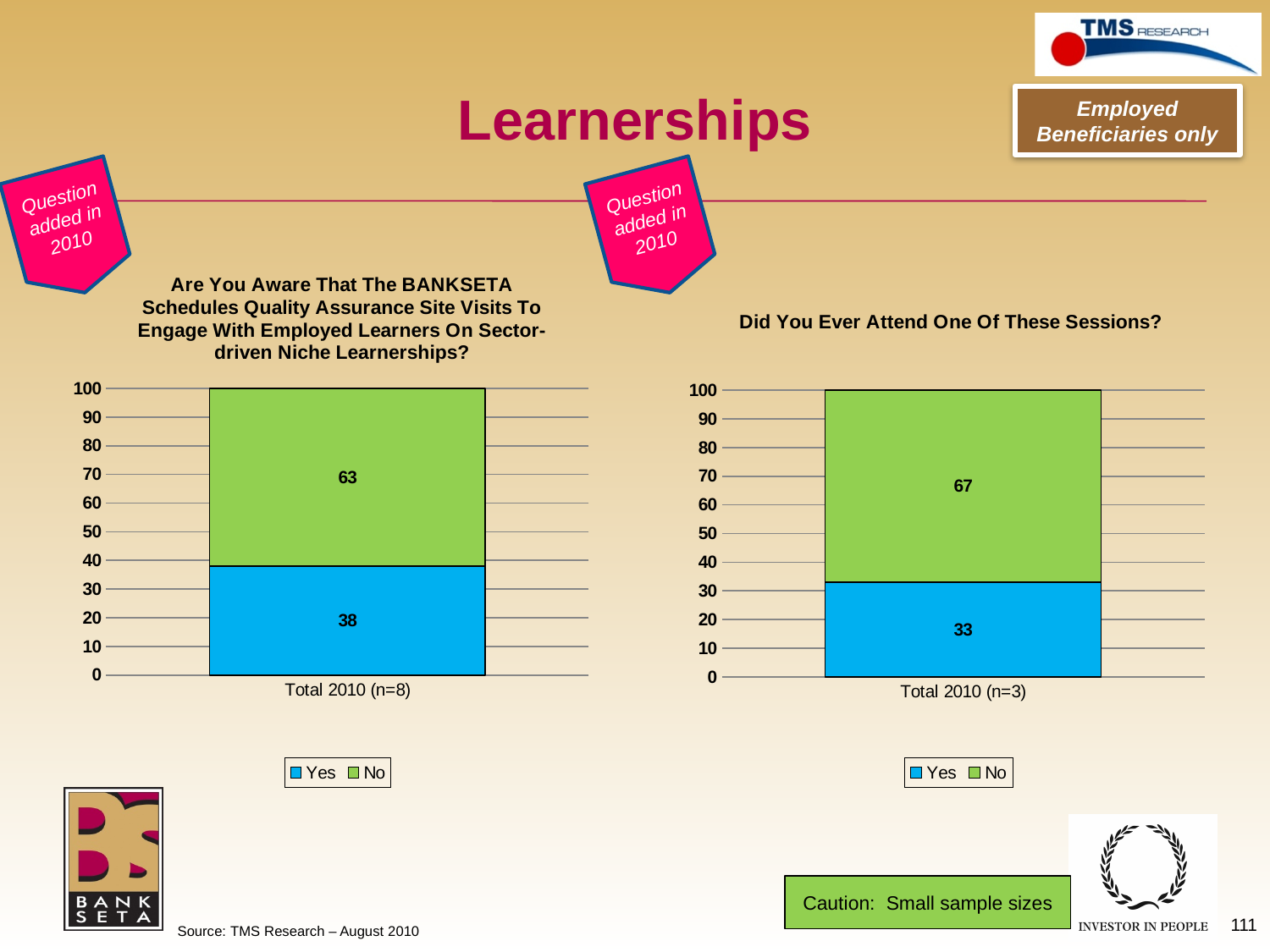
In the right chart (Did You Ever Attend One Of These Sessions?), what is the value for Yes? 33 In the right chart (Did You Ever Attend One Of These Sessions?), which series has the smaller value, Yes or No? Yes What kind of chart is the right chart (Did You Ever Attend One Of These Sessions?)? Stacked bar chart What is the category label on the x axis of the right chart (Did You Ever Attend One Of These Sessions?)? Total 2010 (n=3) In the left chart (Are You Aware That The BANKSETA Schedules Quality Assurance Site Visits...), what is the difference between the No and Yes values? 25 In the right chart (Did You Ever Attend One Of These Sessions?), what is the total of the stacked bar? 100 How many series does the legend of the left chart list? 2 In the left chart (Are You Aware That The BANKSETA Schedules Quality Assurance Site Visits...), what is the value for Yes? 38 In the left chart (Are You Aware That The BANKSETA Schedules Quality Assurance Site Visits...), what is the value for No? 63 In the right chart (Did You Ever Attend One Of These Sessions?), what is the value for No? 67 In the right chart (Did You Ever Attend One Of These Sessions?), what is the difference between the No and Yes values? 34 In the left chart (Are You Aware That The BANKSETA Schedules Quality Assurance Site Visits...), which series has the larger value, Yes or No? No